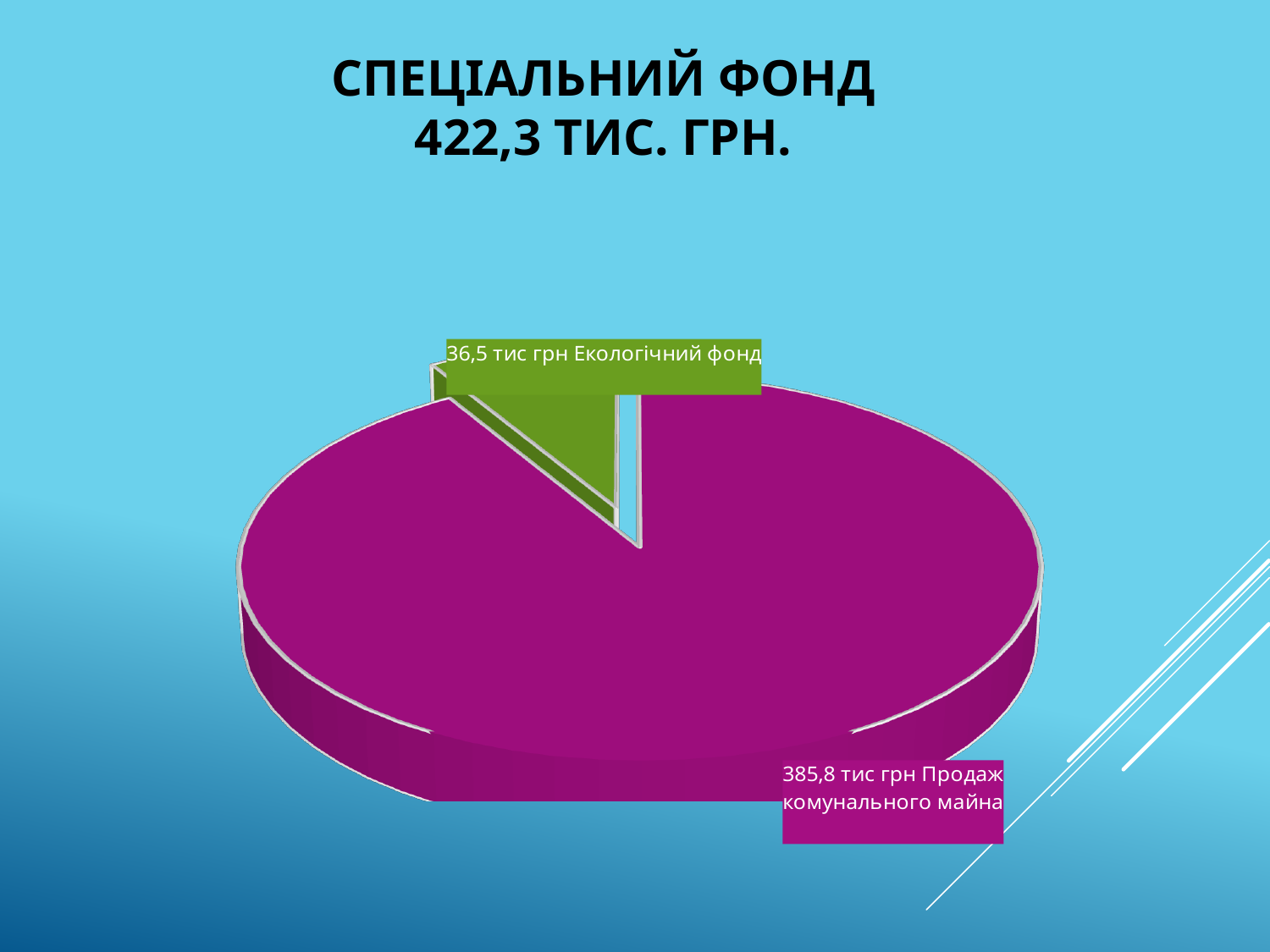
What is the title of the chart? СПЕЦІАЛЬНИЙ ФОНД 422,3 ТИС. ГРН. What value is shown for Продаж комунального майна? 385,8 тис грн What is the total of the two slices shown in the pie chart? 422,3 тис грн How many slices does the pie chart have? 2 What value is shown for Екологічний фонд? 36,5 тис грн What colour is the slice for Екологічний фонд? Green Which is larger: Екологічний фонд or Продаж комунального майна? Продаж комунального майна Which category has the smallest slice of the pie? Екологічний фонд What is the difference between Продаж комунального майна and Екологічний фонд? 349,3 тис грн What kind of chart is shown on the slide? Pie chart Which category has the largest slice of the pie? Продаж комунального майна